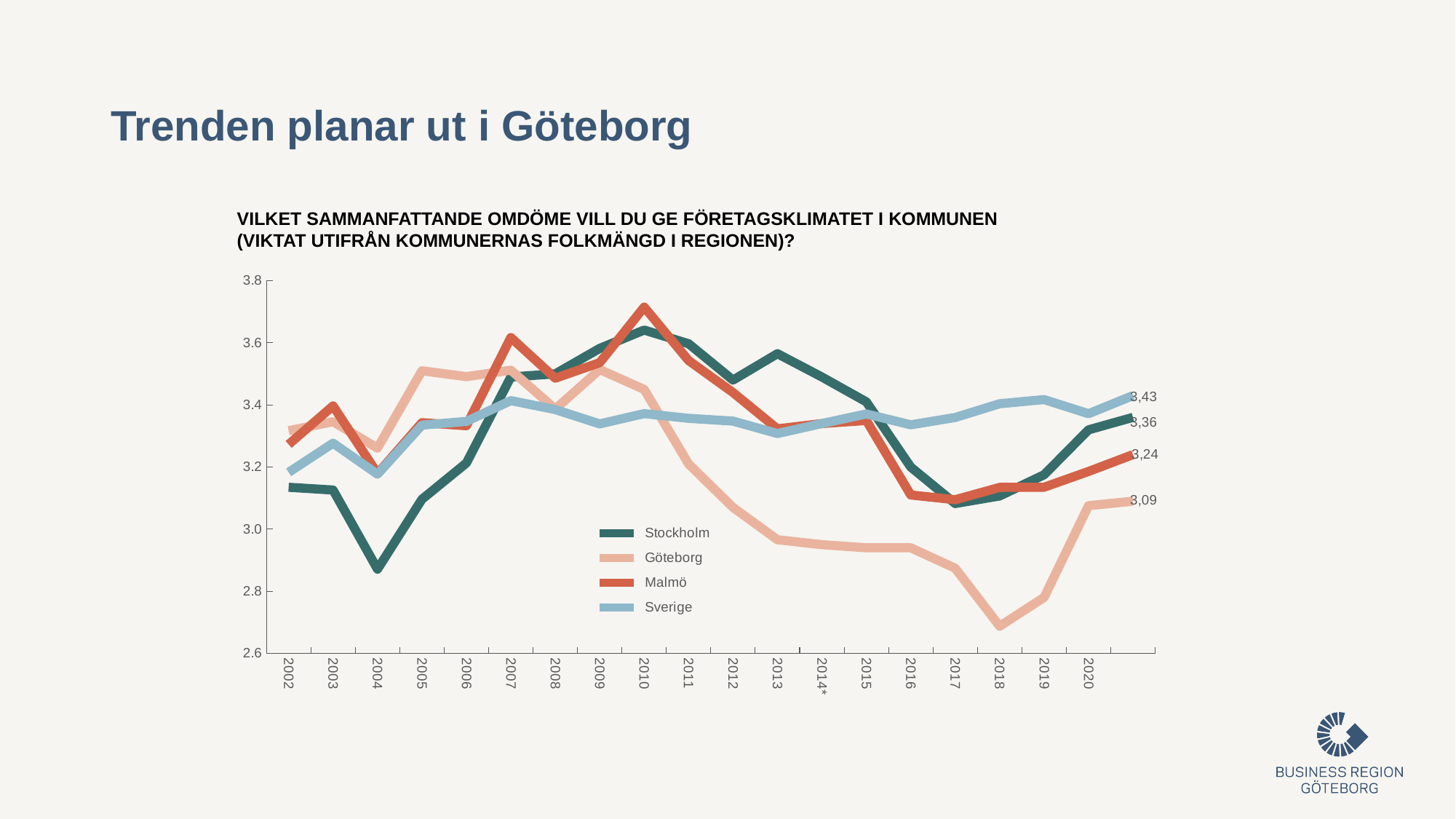
Is the value for Göteborg in 2018 greater or less than 2.8? less What is the final value labelled at the end of the Göteborg line? 3,09 Does the Göteborg line rise or fall between 2011 and 2018? fall Is the value for Malmö in 2010 greater or less than 3.6? greater What is the difference between the final values of Sverige (3,43) and Göteborg (3,09)? 0,34 What kind of chart is shown on the slide? line chart Which series has the lowest value at the end of the chart? Göteborg How many series does the chart legend list? 4 At the end of the chart, which is larger: the Stockholm value or the Malmö value? Stockholm What is the final value labelled at the end of the Malmö line? 3,24 What is the final value labelled at the end of the Sverige line? 3,43 Which series has the highest value at the end of the chart? Sverige